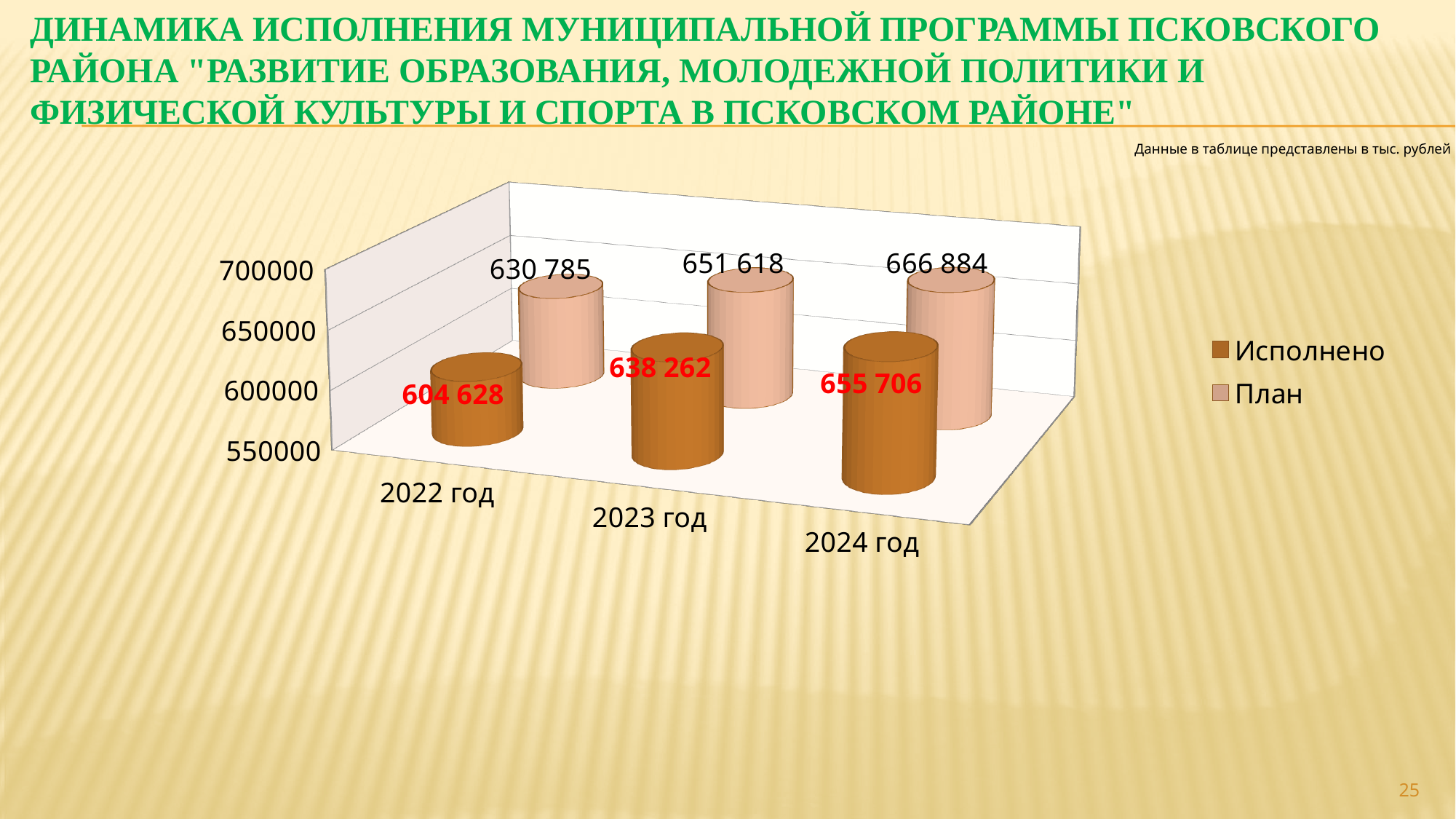
By how much did Исполнено increase from 2022 год to 2024 год? 51 078 What kind of chart is shown on the slide? Bar chart Which year has the lowest План value? 2022 год How many years are shown on the x axis? 3 What is the value of Исполнено for 2022 год? 604 628 Which year has the highest Исполнено value? 2024 год What is the difference between План and Исполнено for 2022 год? 26 157 Do the Исполнено values rise or fall from 2022 год to 2024 год? Rise What is the value of План for 2023 год? 651 618 What is the value of План for 2024 год? 666 884 How many series does the legend list? 2 Which is larger for 2023 год, План or Исполнено? План